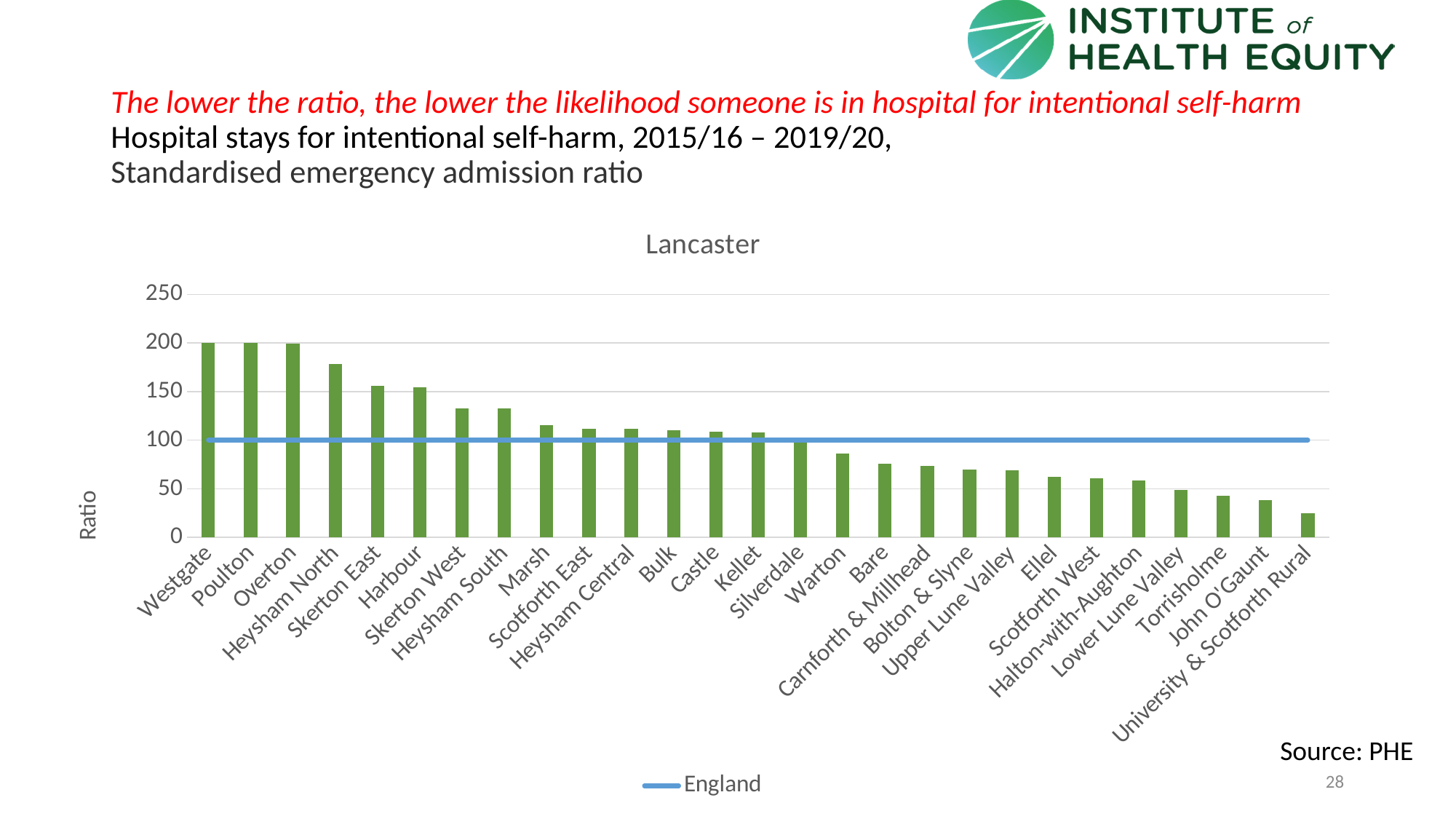
Is the value for Torrisholme greater or less than 50? less Is the value for Westgate greater or less than 150? greater Do the bar values rise or fall moving from left to right along the x axis? Fall What is the title of the chart? Lancaster Which ward has the lowest ratio in the chart? University & Scotforth Rural What kind of chart is shown on the slide? Bar chart How many wards (bars) are plotted in the chart? 27 How many series does the chart legend list? 1 Is the value for Skerton West greater or less than 100? greater Which has the larger ratio, Heysham North or Bare? Heysham North What is the label on the vertical axis of the chart? Ratio